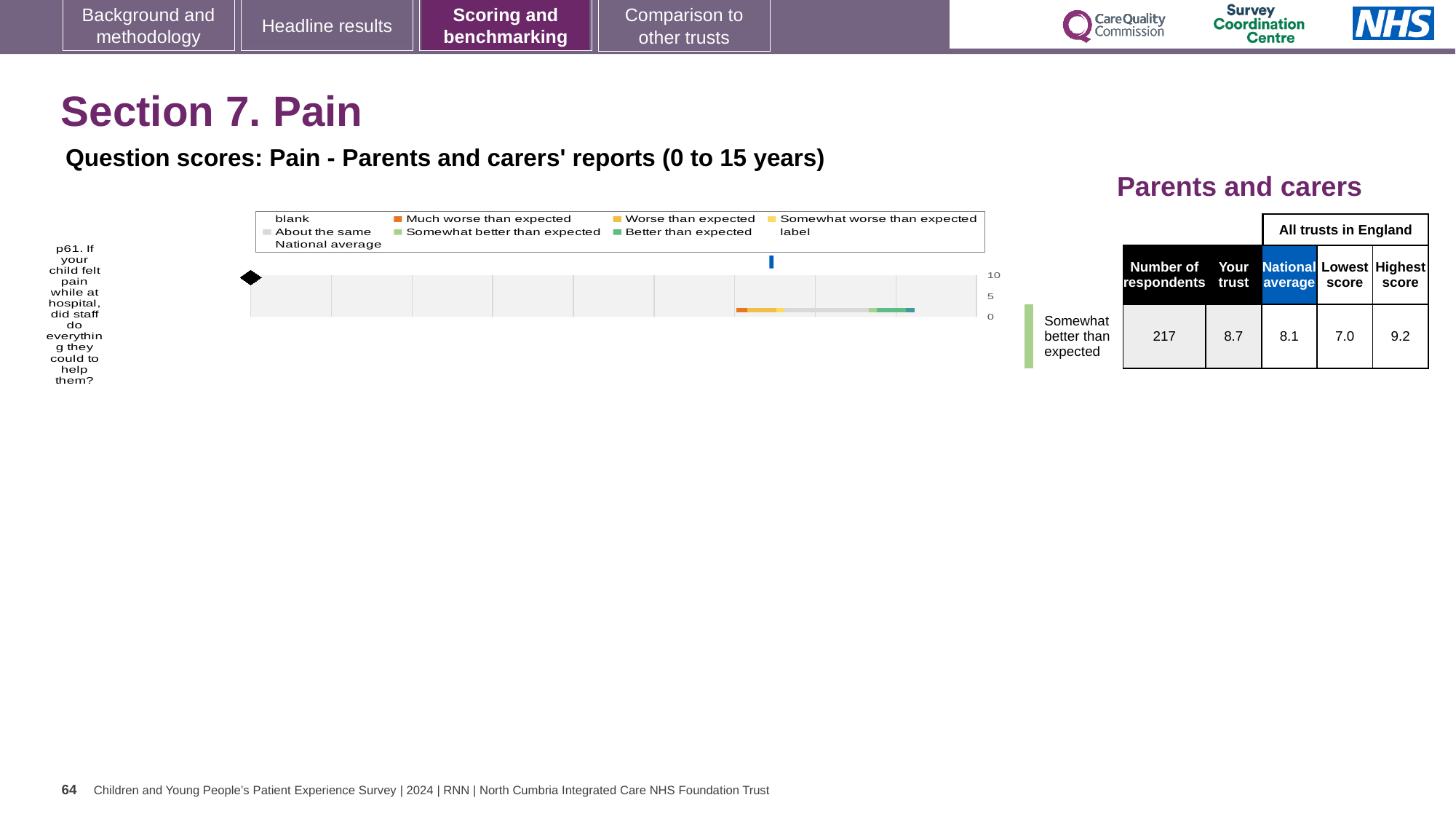
What is the label of the question plotted in the Pain question scores chart? p61. If your child felt pain while at hospital, did staff do everything they could to help them? For question p61, which is larger: the 'Your trust' score or the National average? Your trust What is the Lowest score across all trusts in England for question p61? 7.0 How many survey questions are plotted in the Pain question scores chart? 1 How many respondents are listed for question p61 in the Parents and carers table? 217 Which benchmarking category is the trust's result for question p61 placed in? Somewhat better than expected For question p61, what is the difference between the 'Your trust' score and the National average? 0.6 What is the National average score for question p61 shown in the Parents and carers table? 8.1 What is the 'Your trust' score for question p61 shown in the Parents and carers table? 8.7 What is the Highest score across all trusts in England for question p61? 9.2 For question p61, what is the difference between the Highest score and the Lowest score across all trusts in England? 2.2 What kind of chart is shown on the slide for the Pain question scores? bar chart